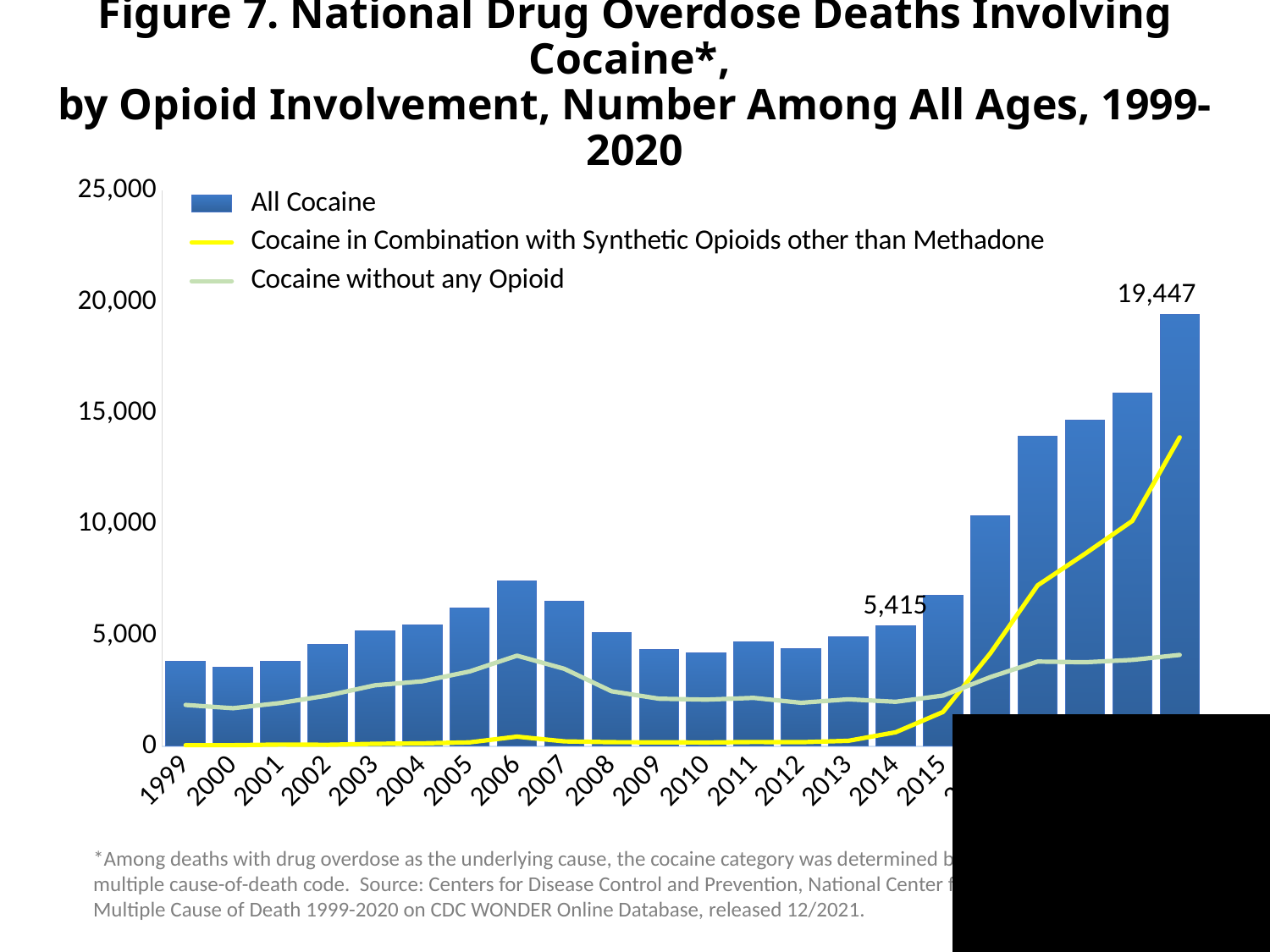
What colour is the line for Cocaine in Combination with Synthetic Opioids other than Methadone? Yellow Do the All Cocaine values rise or fall from 2014 to the last bar? rise What kind of chart is shown? Combined bar and line chart What is the value of the tallest All Cocaine bar? 19,447 Which year has the larger All Cocaine value, 2006 or 2007? 2006 What is the All Cocaine value for 2014? 5,415 What is the difference between the two labeled All Cocaine values, 19,447 and 5,415? 14,032 Is the All Cocaine value for 2006 greater or less than 5,000? greater Which year has the larger All Cocaine value, 2001 or 2002? 2002 Does the Cocaine without any Opioid line rise or fall from 2006 to 2009? fall How many series does the legend list? 3 Is the All Cocaine value for 2010 greater or less than 5,000? less